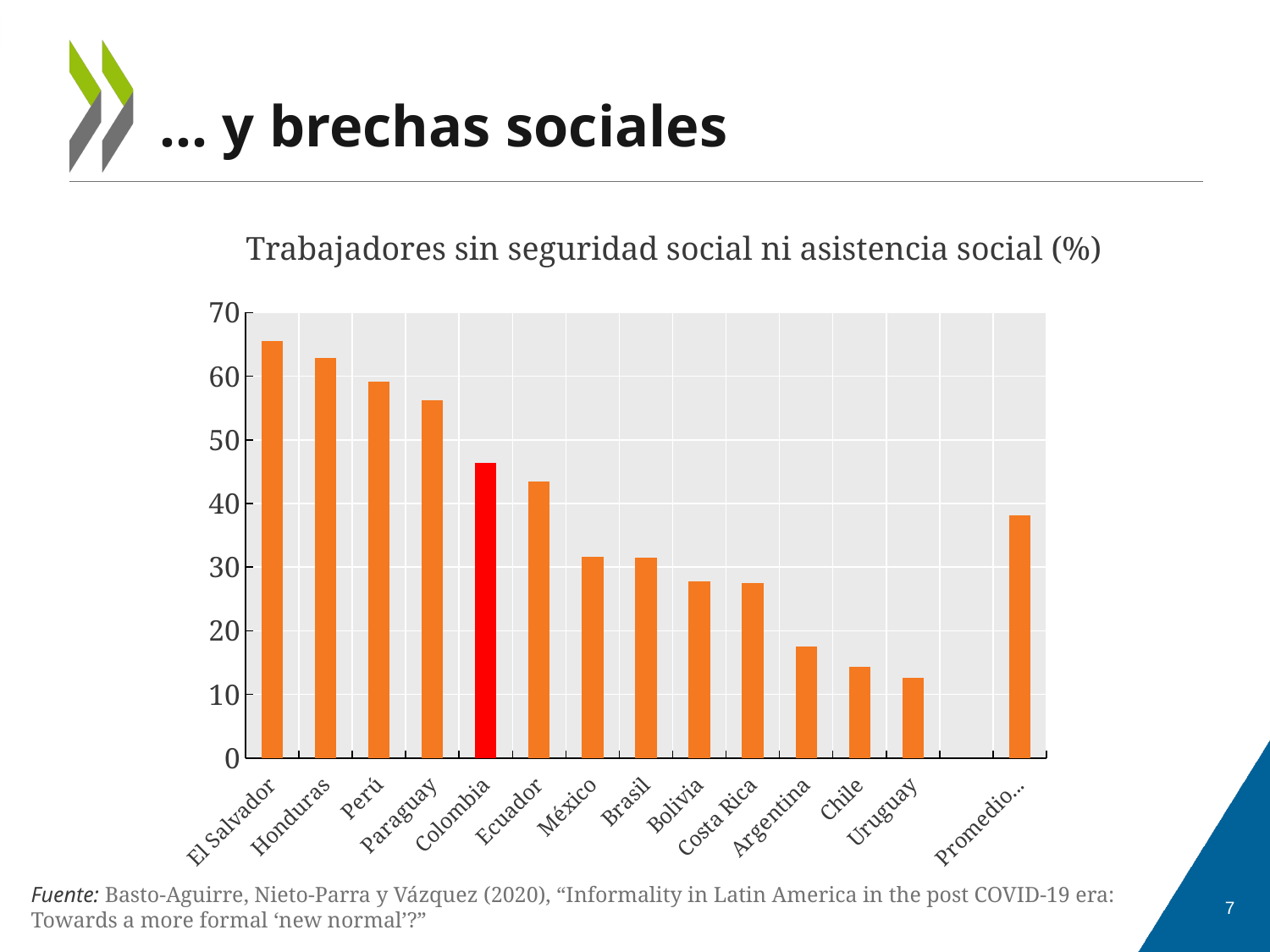
Which country has the lowest share of workers without social security or social assistance? Uruguay How many bars are plotted in the chart? 14 Which has a higher value, Colombia or Ecuador? Colombia Is the value for El Salvador greater or less than 60? greater Which country has the highest share of workers without social security or social assistance? El Salvador Is the value for Colombia greater or less than 50? less What is the title of the chart? Trabajadores sin seguridad social ni asistencia social (%) What kind of chart is shown on the slide? Bar chart Which bar is highlighted in red rather than orange? Colombia Is the value for Chile greater or less than 20? less Which has a higher value, Argentina or Chile? Argentina